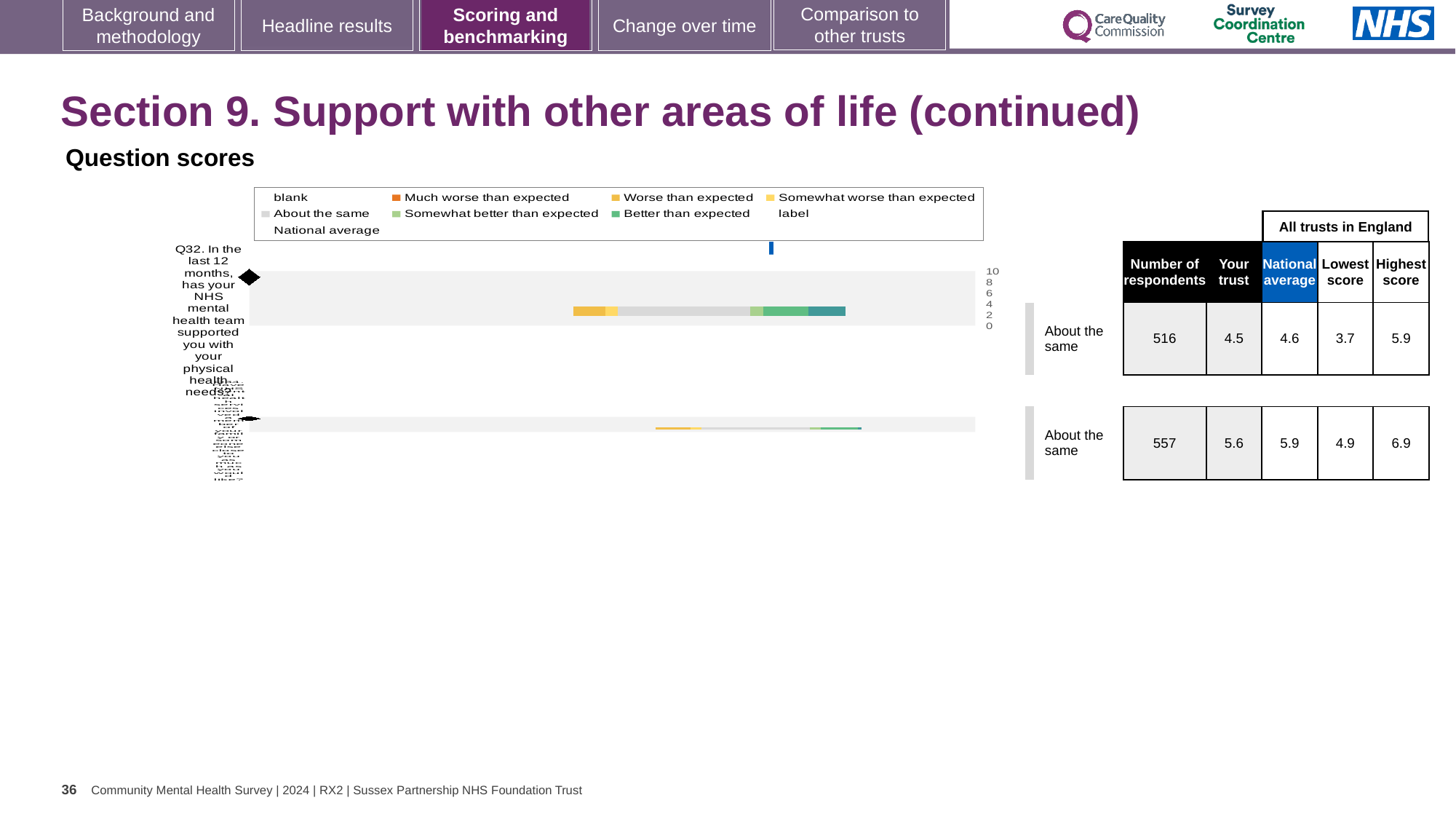
What is the difference between the highest and lowest scores for Q32? 2.2 What is the 'Your trust' score for the second (lower) question row? 5.6 What benchmark category is shown next to the Q32 bar? About the same For Q32, which is larger: the 'Your trust' score or the national average? National average What is the national average score for Q32? 4.6 What is the highest score among all trusts in England for Q32? 5.9 What is the number of respondents for Q32 (support with physical health needs)? 516 What is the number of respondents for the second (lower) question row? 557 How many question rows are plotted in the chart? 2 What is the lowest score among all trusts in England for Q32? 3.7 What is the 'Your trust' score for Q32? 4.5 What type of chart is shown on the slide? bar chart